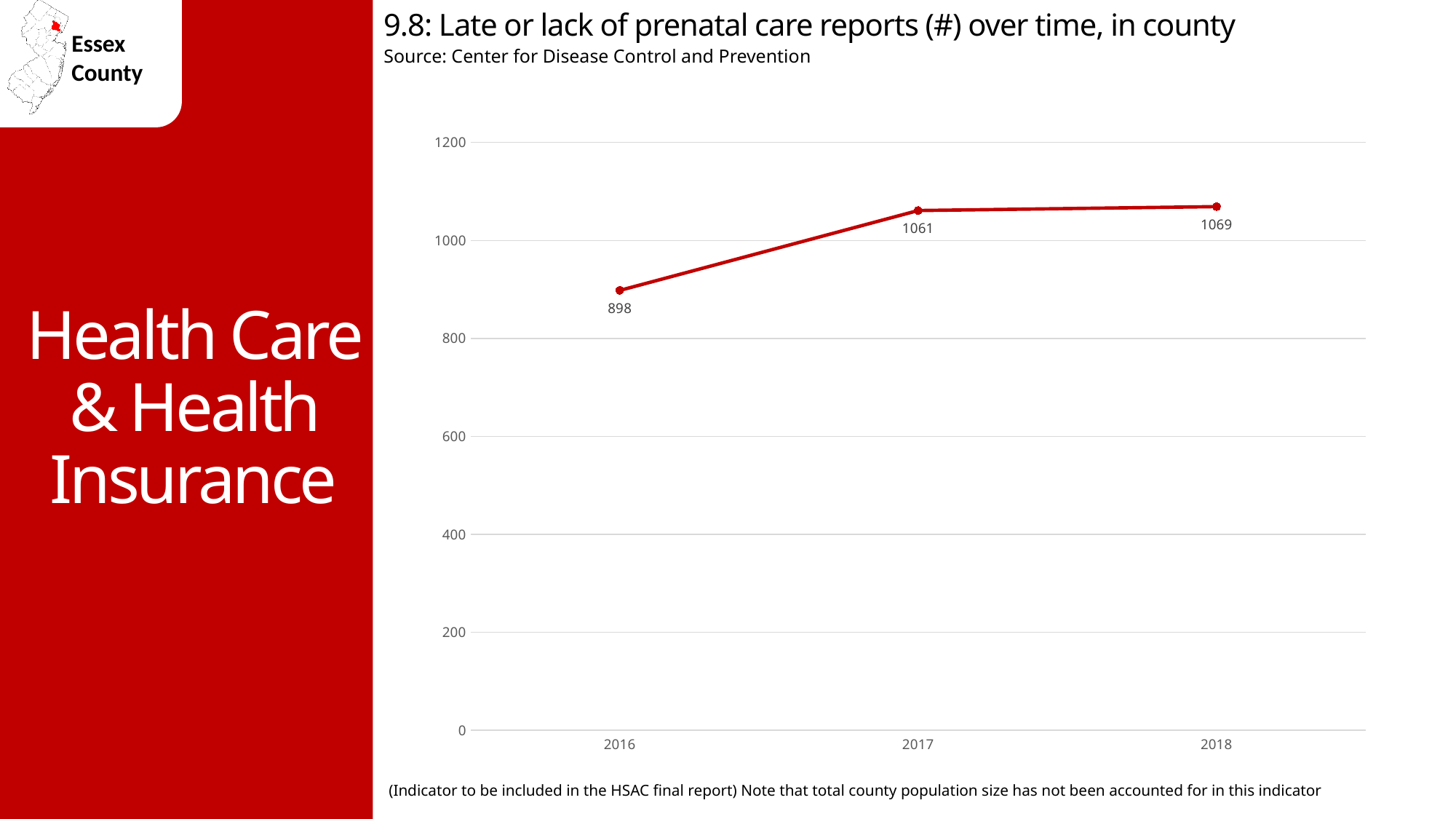
What is the number of late or lack of prenatal care reports in 2018? 1069 What is the source of the data shown in the chart? Center for Disease Control and Prevention What is the difference in reports between 2017 and 2016? 163 Is the value for 2016 greater or less than 1000? less What is the difference in reports between 2018 and 2017? 8 Which year has more reports, 2016 or 2017? 2017 Which year has the lowest number of late or lack of prenatal care reports? 2016 What is the number of late or lack of prenatal care reports in 2017? 1061 Do the values rise or fall from 2016 to 2018? rise What kind of chart is shown on the slide? line chart How many years are plotted on the chart? 3 What is the number of late or lack of prenatal care reports in 2016? 898